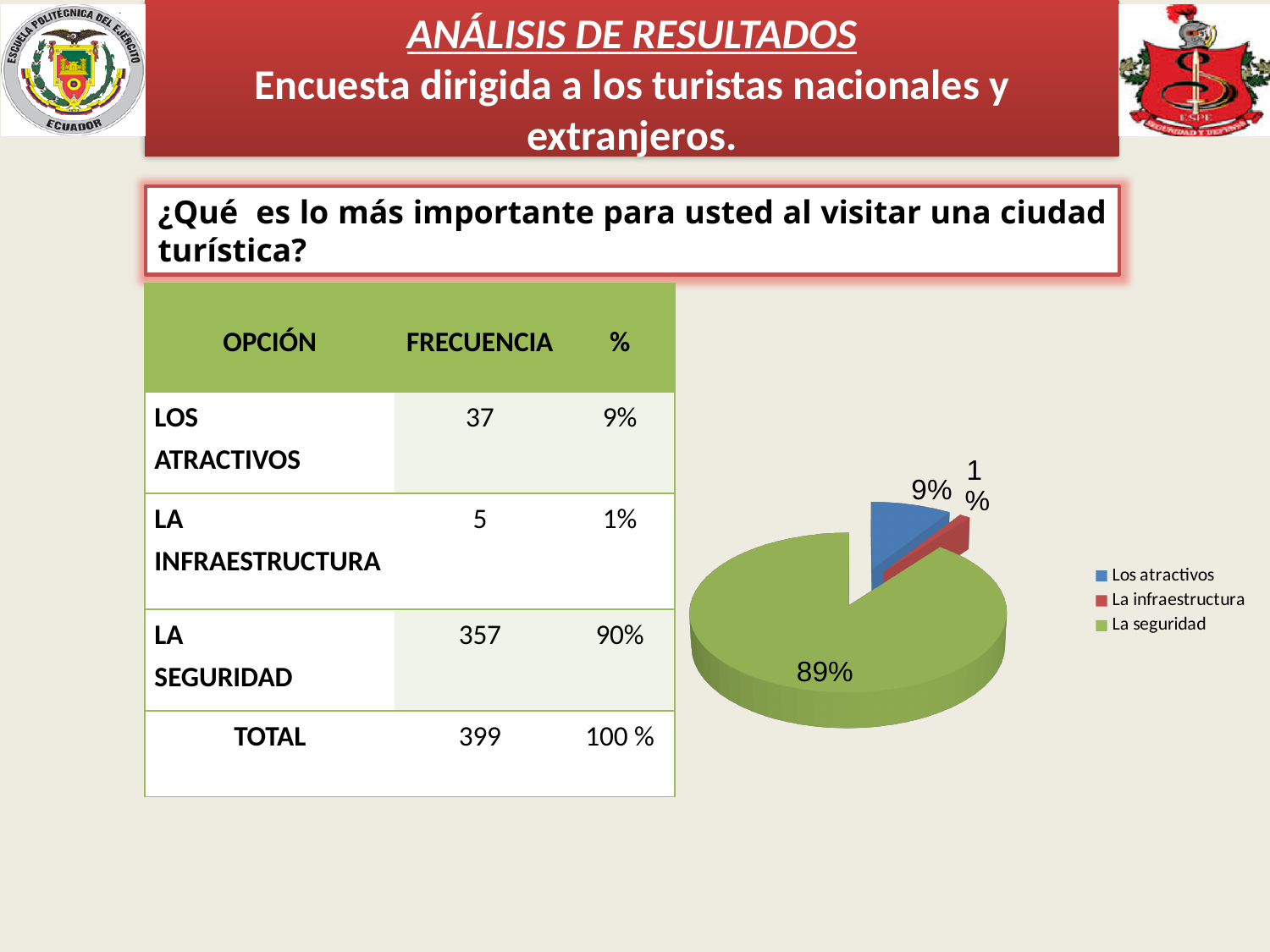
How many slices does the pie chart have? 3 How many entries does the pie chart's legend list? 3 Which slice of the pie chart is the smallest? La infraestructura What percentage does the pie chart show for La seguridad? 89% In the pie chart, which is larger: Los atractivos or La infraestructura? Los atractivos What percentage does the pie chart show for Los atractivos? 9% Which slice of the pie chart is the largest? La seguridad What kind of chart is shown on the slide? pie chart What percentage does the pie chart show for La infraestructura? 1% What colour is the Los atractivos slice in the pie chart? blue In the pie chart, what is the difference in percentage points between La seguridad and Los atractivos? 80 What colour is the La seguridad slice in the pie chart? green